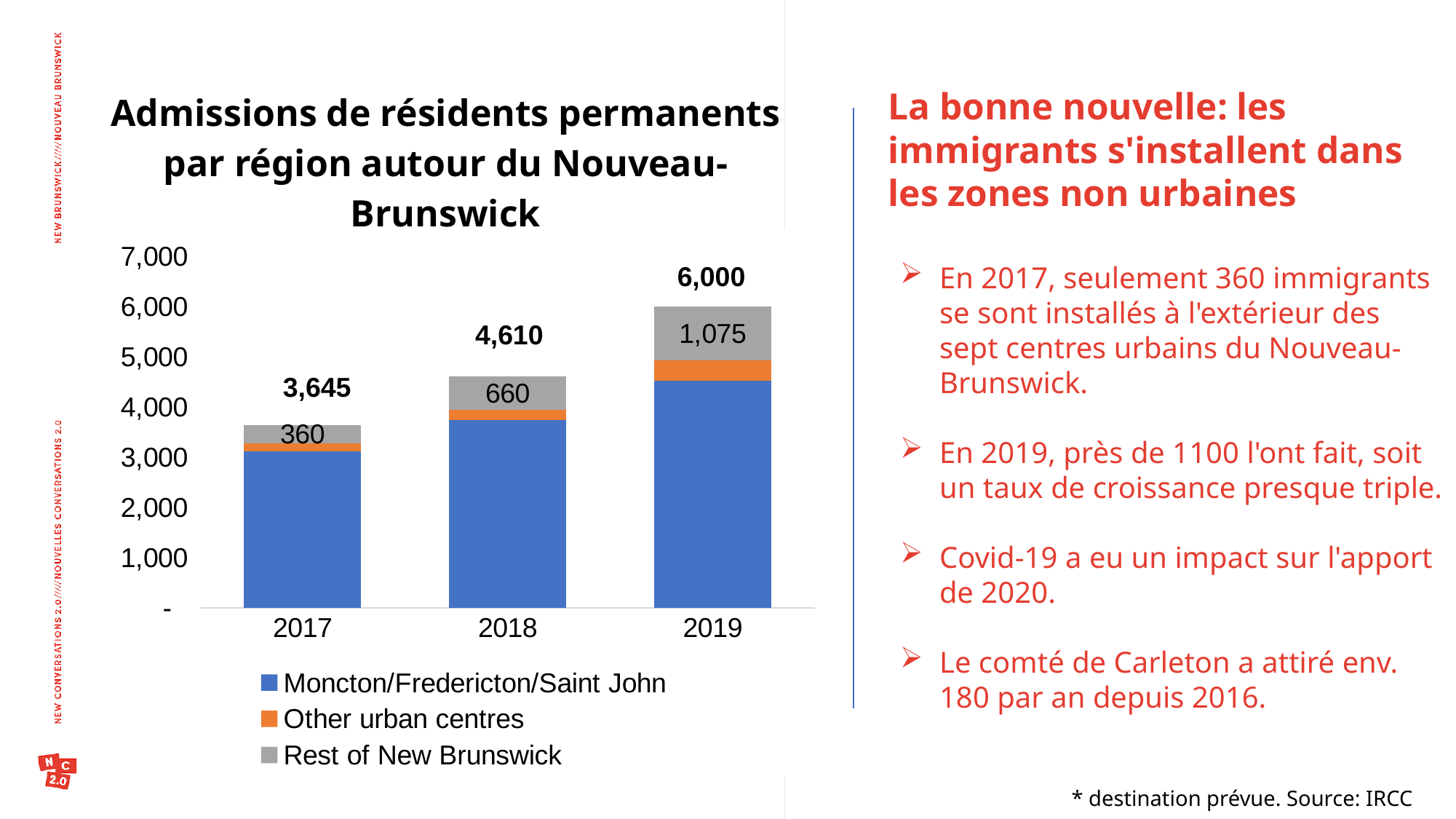
Is the Moncton/Fredericton/Saint John value for 2019 greater or less than 4,000? greater How many series does the legend list? 3 Do the total admissions rise or fall from 2017 to 2019? Rise By how much did the Rest of New Brunswick value increase from 2017 to 2019? 715 What value is labelled for Rest of New Brunswick in 2019? 1,075 What is the difference between the total admissions in 2019 and in 2017? 2,355 What kind of chart is shown on the slide? Stacked bar chart Which year has the lowest total admissions? 2017 What value is labelled for Rest of New Brunswick in 2018? 660 What is the total number of permanent resident admissions shown for 2019? 6,000 What is the total number of permanent resident admissions shown for 2017? 3,645 Which year has the highest total admissions? 2019